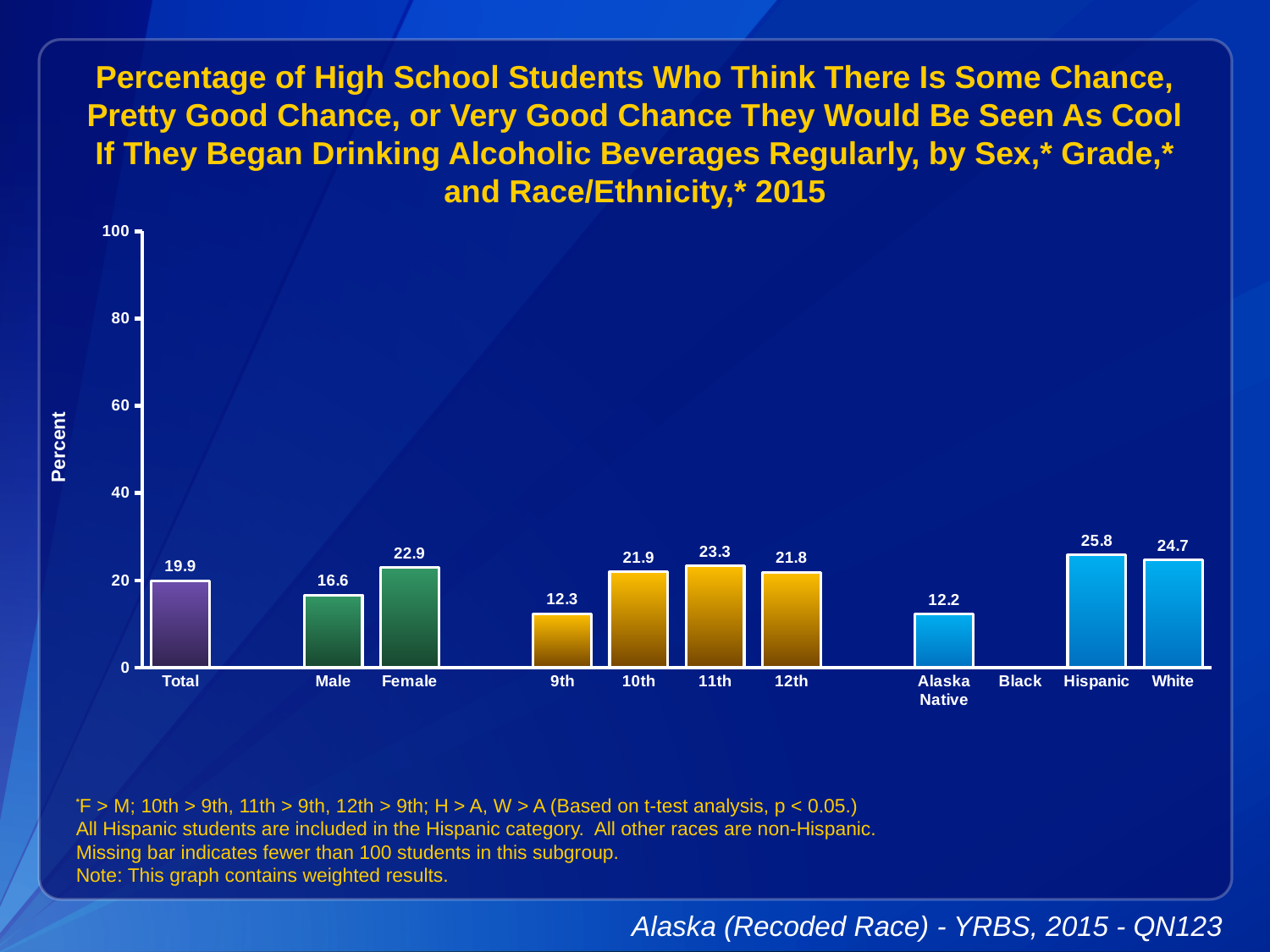
What kind of chart is shown? Bar chart Is the value for White greater or less than 20? greater Which category label has no bar shown? Black How many bars are plotted on the chart? 10 Which is larger, the value for 11th grade or 12th grade? 11th Which category has the lowest value among the bars shown? Alaska Native What is the value for Alaska Native? 12.2 What is the difference between the Female and Male values? 6.3 Which category has the highest value? Hispanic What is the value for 9th grade? 12.3 What is the value for Total? 19.9 What is the value for Female? 22.9